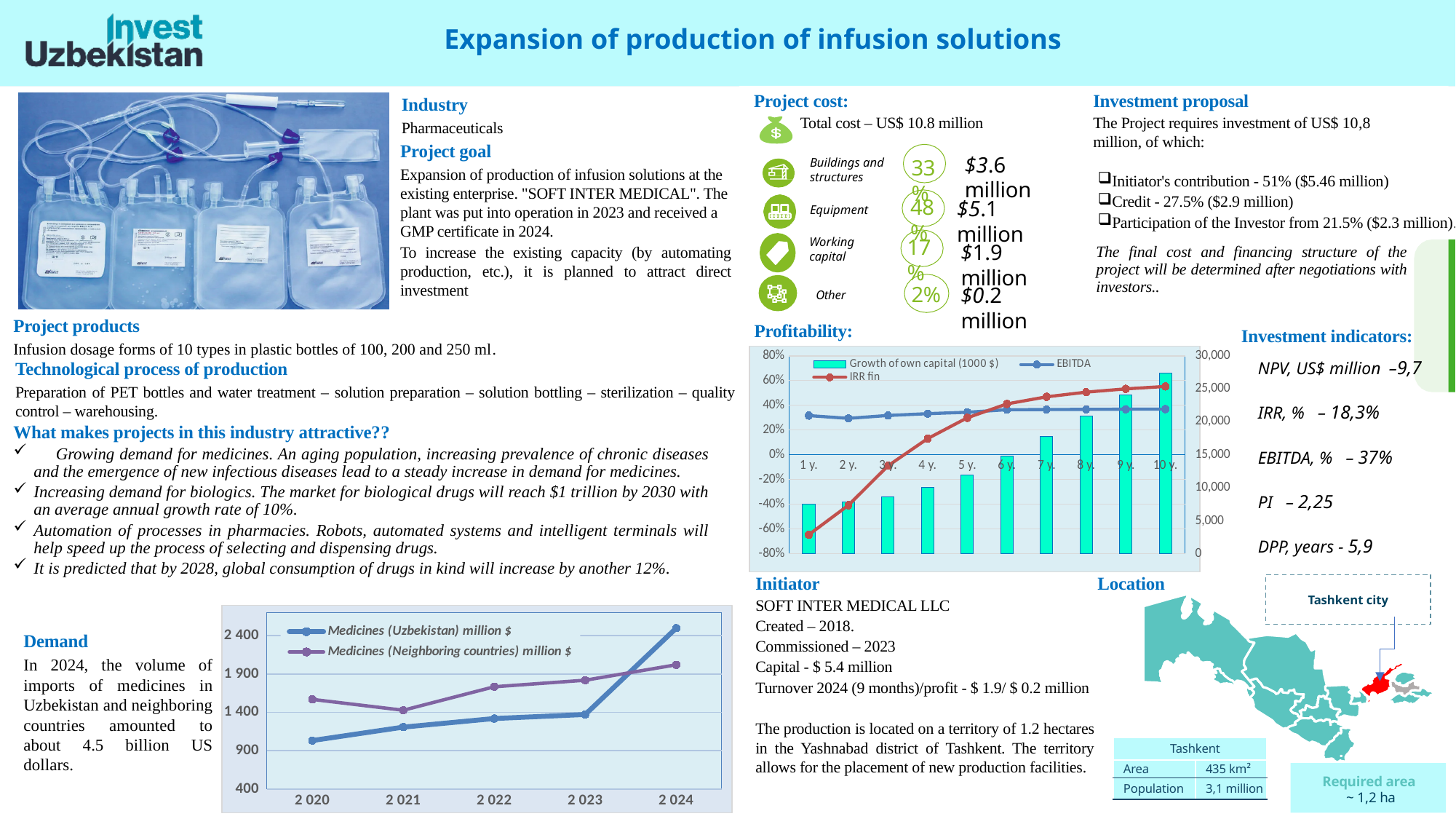
On the Demand chart, which series has the larger value in 2020, Medicines (Uzbekistan) or Medicines (Neighboring countries)? Medicines (Neighboring countries) On the Profitability chart, how many year categories are shown on the x axis? 10 On the Demand chart, is the value for Medicines (Uzbekistan) in 2021 greater or less than 1 400? less On the Demand chart, in which year is the value for Medicines (Uzbekistan) highest? 2024 On the Demand chart, in which year is the value for Medicines (Neighboring countries) lowest? 2021 On the Profitability chart, how many series does the legend list? 3 On the Demand chart, does the Medicines (Uzbekistan) series rise or fall from 2020 to 2024? Rise On the Profitability chart, is the IRR fin value at 10 y. greater or less than 40%? greater On the Demand chart (bottom centre), how many series does the legend list? 2 On the Demand chart, which series has the larger value in 2024, Medicines (Uzbekistan) or Medicines (Neighboring countries)? Medicines (Uzbekistan) What kind of chart is the Demand chart showing medicines imports? Line chart On the Demand chart, how many years are shown on the x axis? 5